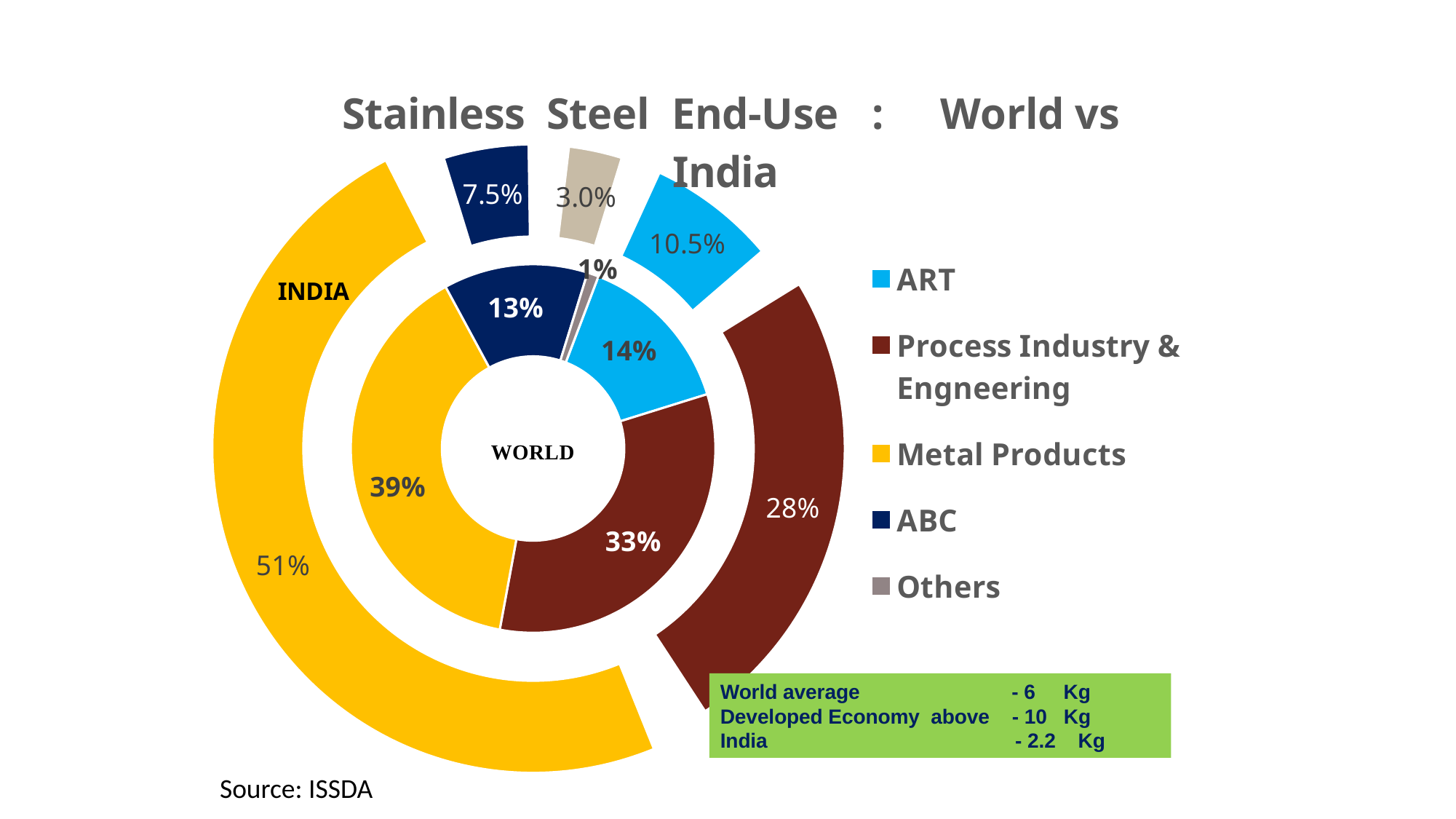
What is the India share for ABC? 7.5% Which end-use category has the smallest share in the India ring? Others What is the India share for Metal Products? 51% What is the difference between the India and World shares for Metal Products? 12% Which end-use category has the largest share in the World ring? Metal Products How many end-use categories does the legend list? 5 What kind of chart is shown on the slide? Doughnut chart Which is larger: the World share for ABC or the India share for ABC? World share for ABC What is the source cited for the chart? ISSDA What is the World share for Process Industry & Engneering? 33% What is the World share for Metal Products? 39% What is the India share for ART? 10.5%